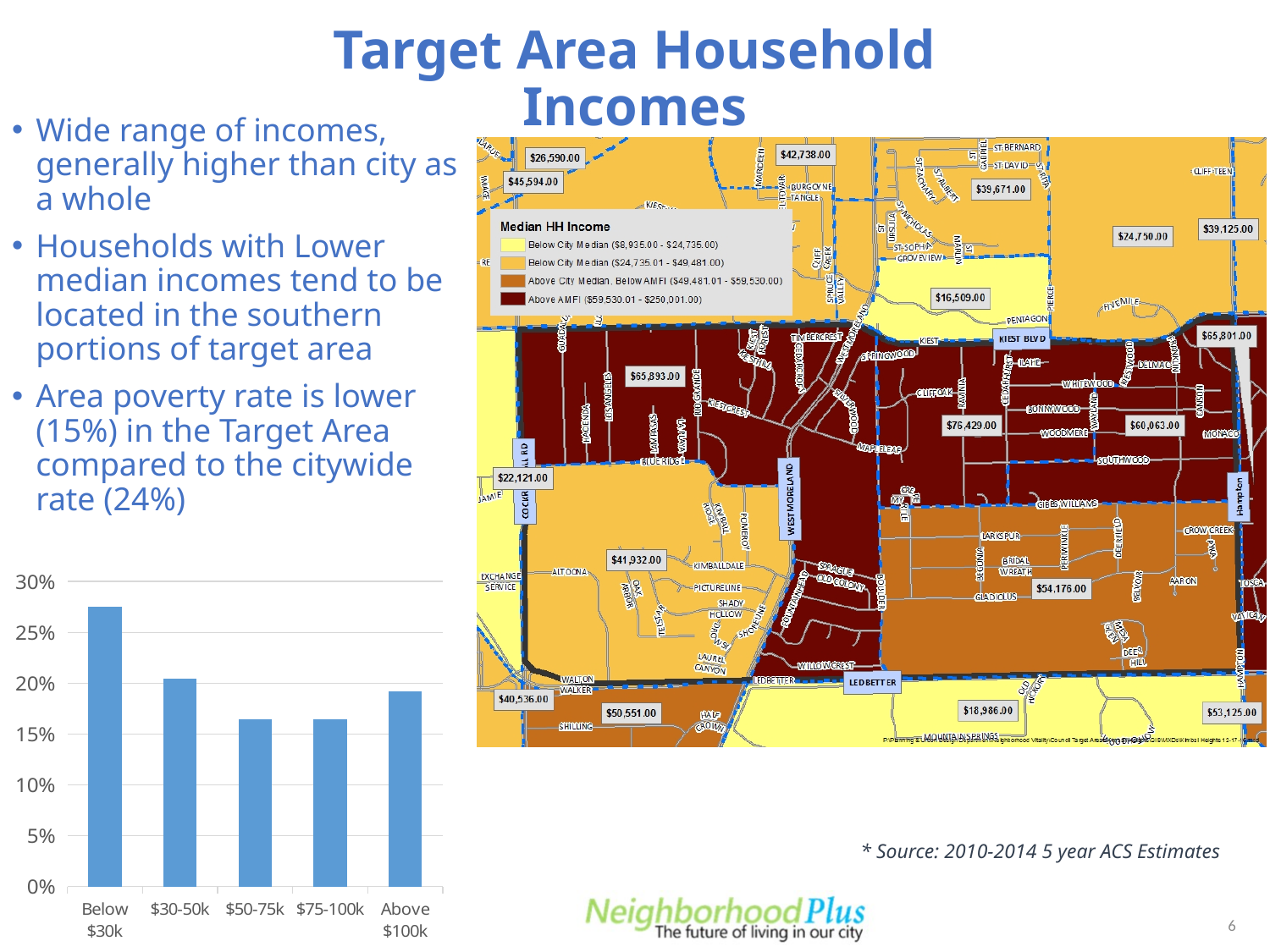
In the bar chart, do the values rise or fall from Below $30k to $50-75k? fall In the bar chart, is the value for $30-50k greater or less than 25%? less In the bar chart, is the value for Below $30k greater or less than 25%? greater What kind of chart is shown at the bottom left of the slide? bar chart In the bar chart, is the value for $50-75k greater or less than 20%? less In the bar chart, which is larger: the value for $30-50k or the value for $50-75k? $30-50k In the bar chart, which is larger: the value for Below $30k or the value for Above $100k? Below $30k Which income category has the highest bar in the bar chart? Below $30k What is the highest value labelled on the y axis of the bar chart? 30% How many income categories are shown on the x axis of the bar chart? 5